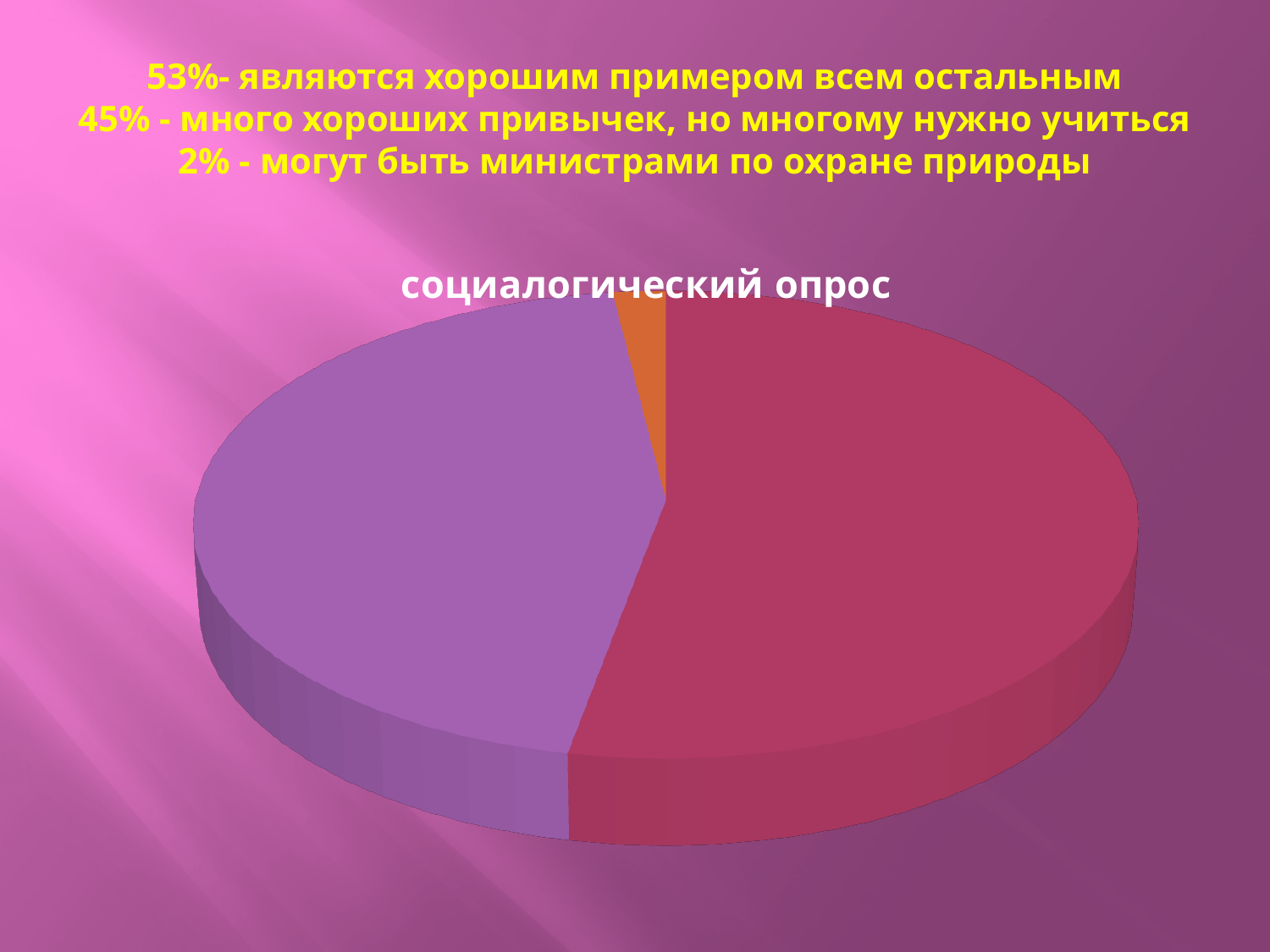
Which slice is larger, the purple one or the orange one? the purple one Which slice of the pie chart is the smallest? the orange slice Which slice is larger, the red one or the purple one? the red one What kind of chart is shown on the slide? pie chart Does the pie chart have a legend? No According to the text on the slide, what share of the pie does the smallest (orange) slice represent? 2% Is the red slice greater or less than half of the pie? greater According to the text on the slide, what share of the pie does the largest (red) slice represent? 53% How many slices does the pie chart have? 3 What is the title of the chart? социалогический опрос Is the purple slice greater or less than half of the pie? less Which slice of the pie chart is the largest? the red slice